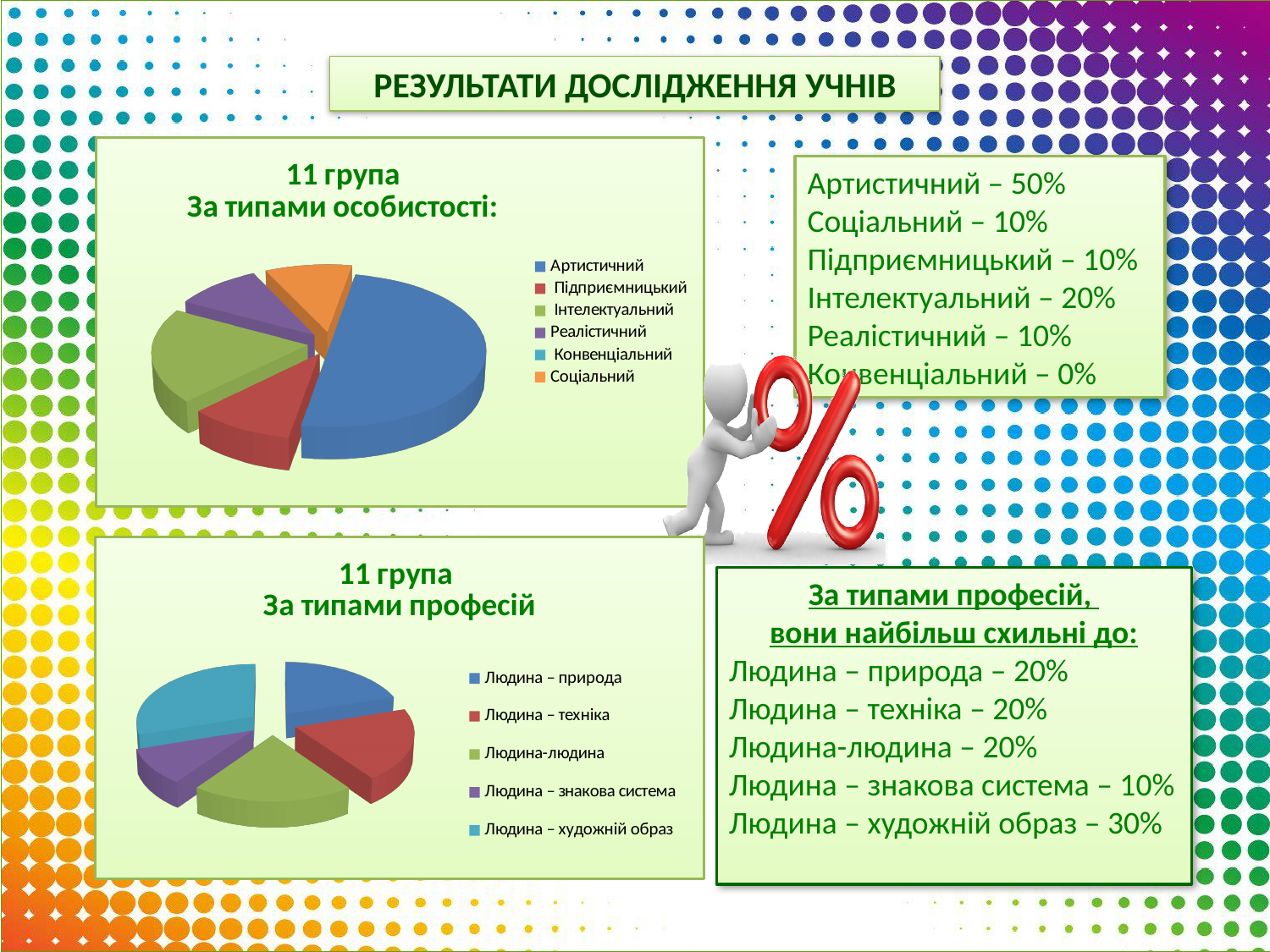
What kind of chart is the top chart titled "11 група За типами особистості"? pie chart In the bottom chart "За типами професій", which profession type has the largest share? Людина – художній образ In the top chart "За типами особистості", what is the value for Інтелектуальний? 20% In the top chart "За типами особистості", how many categories does the legend list? 6 In the top chart "За типами особистості", which personality type has the largest share? Артистичний What kind of chart is the bottom chart titled "11 група За типами професій"? pie chart In the bottom chart "За типами професій", what is the value for Людина – знакова система? 10% In the top chart "За типами особистості", which type has the smallest share? Конвенціальний In the bottom chart "За типами професій", which is larger: Людина – художній образ or Людина – техніка? Людина – художній образ In the top chart "За типами особистості", what is the share for Артистичний? 50% In the top chart "За типами особистості", what is the difference between Артистичний and Інтелектуальний? 30% In the bottom chart "За типами професій", how many categories does the legend list? 5